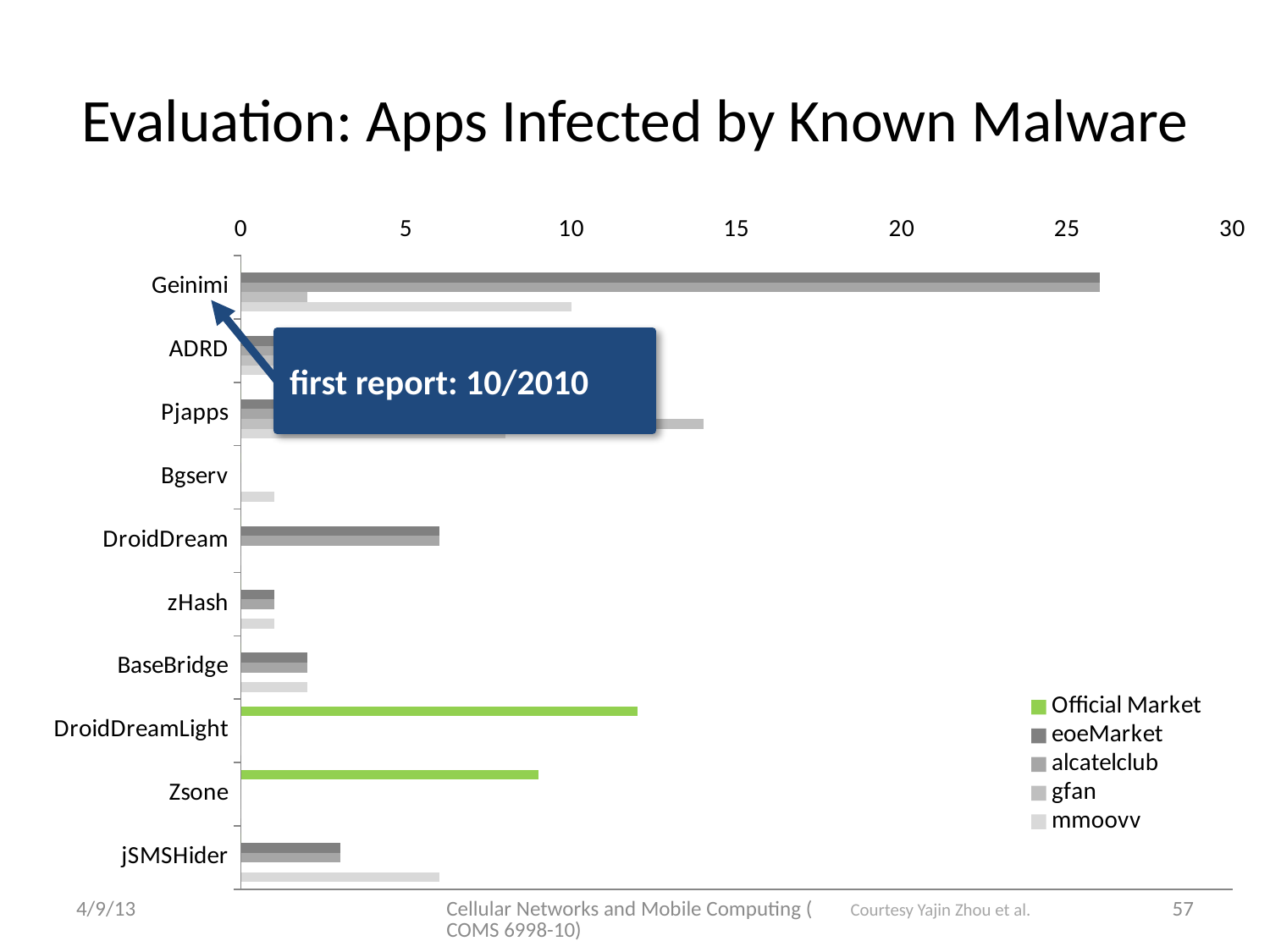
Which series is shown in green in the chart's legend? Official Market Which has the larger Official Market value, DroidDreamLight or Zsone? DroidDreamLight Is the Official Market value for DroidDreamLight greater or less than 10? greater Is the eoeMarket value for DroidDream greater or less than 10? less Which malware family has the longest bar in the chart? Geinimi How many series does the chart's legend list? 5 Is the Official Market value for Zsone greater or less than 5? greater How many malware families (categories) are listed on the vertical axis of the chart? 10 What does the callout box pointing at Geinimi say? first report: 10/2010 What kind of chart is shown on the slide? bar chart